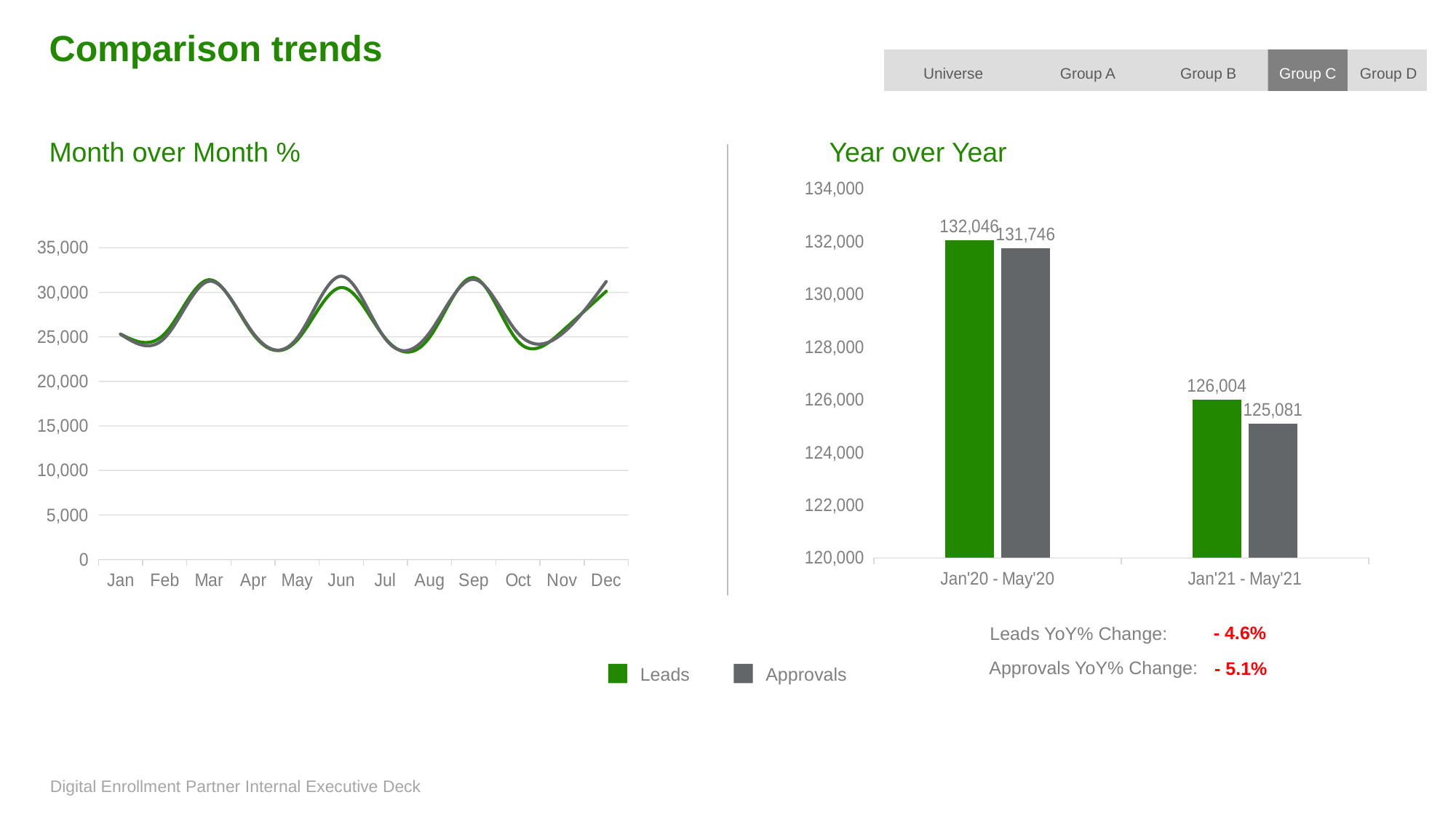
In the Year over Year chart, what is the Approvals value for Jan'20 - May'20? 131,746 How many series does the legend list? 2 What kind of chart is the Month over Month % chart? Line chart How many months are shown on the x axis of the Month over Month % chart? 12 In the Year over Year chart, how much did Leads fall from Jan'20 - May'20 to Jan'21 - May'21? 6,042 In the Month over Month % chart, is the Approvals value for Sep greater or less than 30,000? greater In the Year over Year chart, what is the Leads value for Jan'20 - May'20? 132,046 In the Year over Year chart, what is the Approvals value for Jan'21 - May'21? 125,081 In the Year over Year chart, what is the difference between Leads and Approvals for Jan'21 - May'21? 923 In the Year over Year chart, which period has the higher Approvals value? Jan'20 - May'20 In the Year over Year chart, which bar is the lowest? Approvals, Jan'21 - May'21